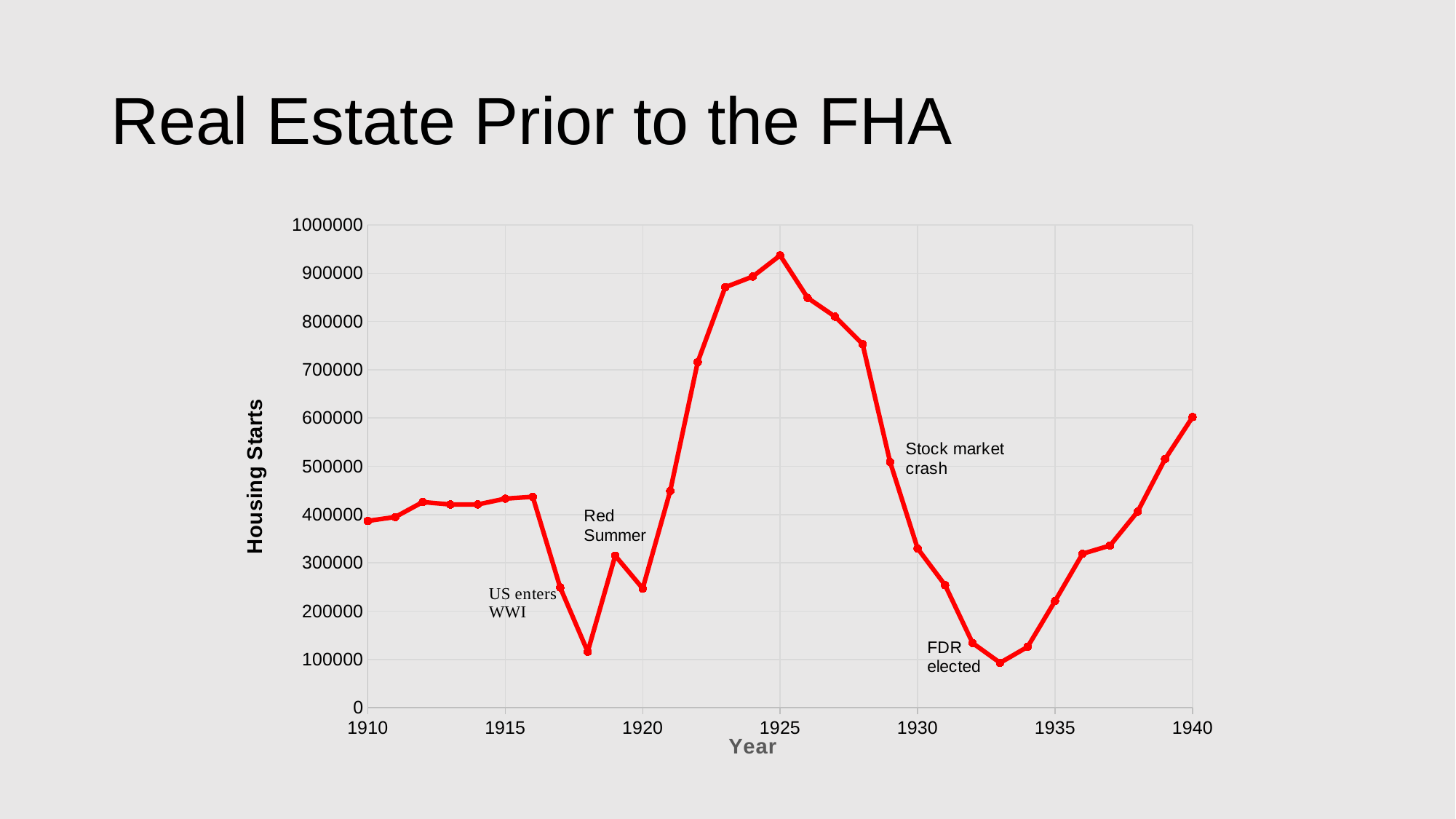
Which year has more housing starts, 1940 or 1910? 1940 What is the label on the vertical axis? Housing Starts Is the value for 1923 greater or less than 800000? greater What kind of chart is shown on the slide? line chart Do housing starts rise or fall between 1933 and 1940? rise Do housing starts rise or fall between 1929 and 1933? fall Is the value for 1918 greater or less than 200000? less Which year has more housing starts, 1916 or 1917? 1916 Is the value for 1940 greater or less than 500000? greater In which year do housing starts reach their lowest point? 1933 In which year do housing starts reach their highest point? 1925